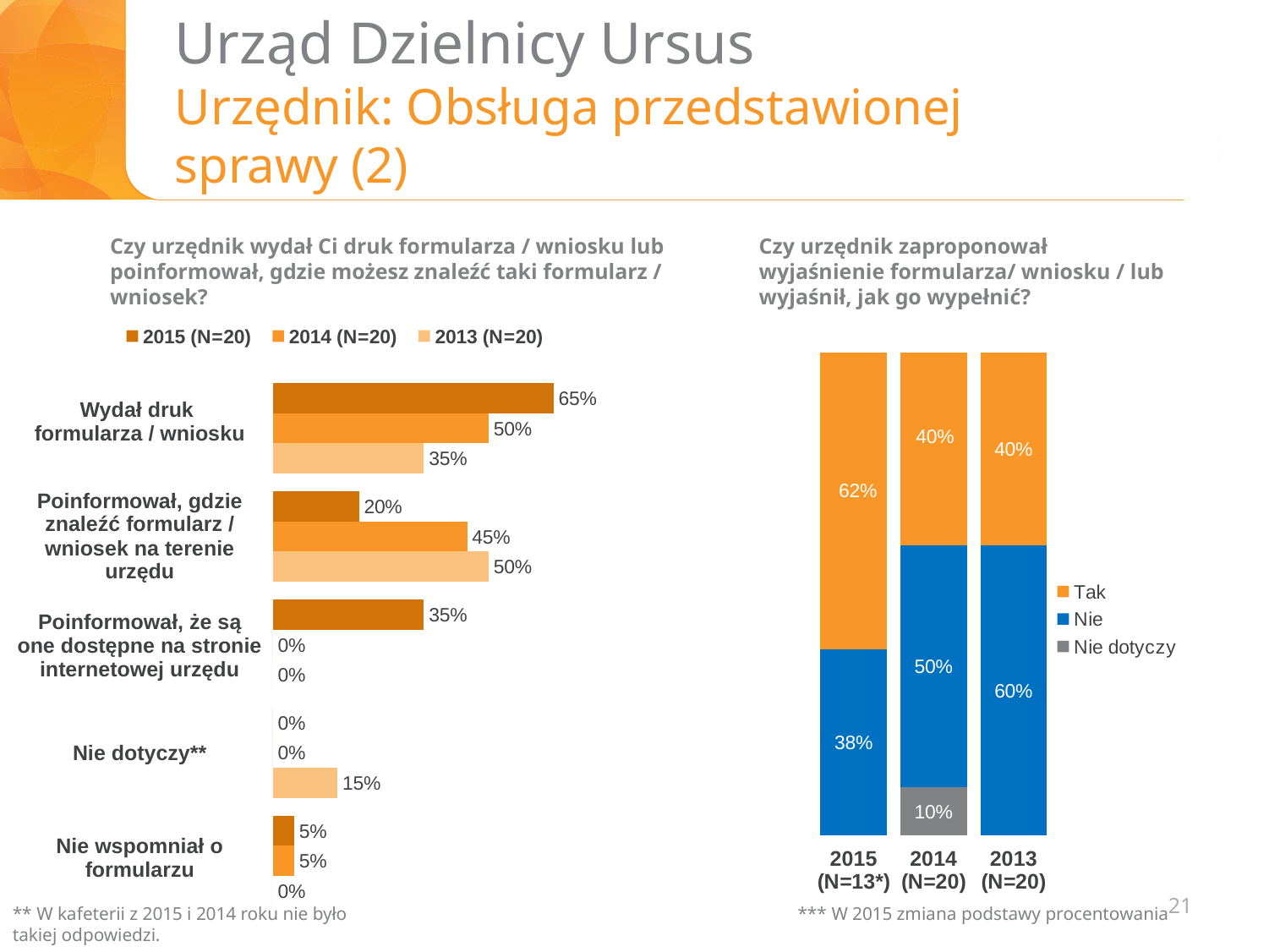
What type of chart is the right chart? Stacked bar chart In the left chart, what is the 2015 value for 'Wydał druk formularza / wniosku'? 65% In the left chart, what is the 2013 value for 'Poinformował, gdzie znaleźć formularz / wniosek na terenie urzędu'? 50% In the left chart, what is the 2013 value for 'Nie dotyczy**'? 15% In the right chart, what is the 'Nie dotyczy' value for 2014 (N=20)? 10% In the right chart, what is the 'Tak' value for 2015 (N=13*)? 62% How many series does the legend of the left chart list? 3 In the left chart, which is larger for 'Poinformował, gdzie znaleźć formularz / wniosek na terenie urzędu': the 2015 value or the 2014 value? 2014 In the left chart, which category has the highest 2015 value? Wydał druk formularza / wniosku How many categories are shown in the left chart? 5 In the right chart, which year has the highest 'Nie' value? 2013 (N=20) In the left chart, what is the difference between the 2015 and 2013 values for 'Wydał druk formularza / wniosku'? 30%